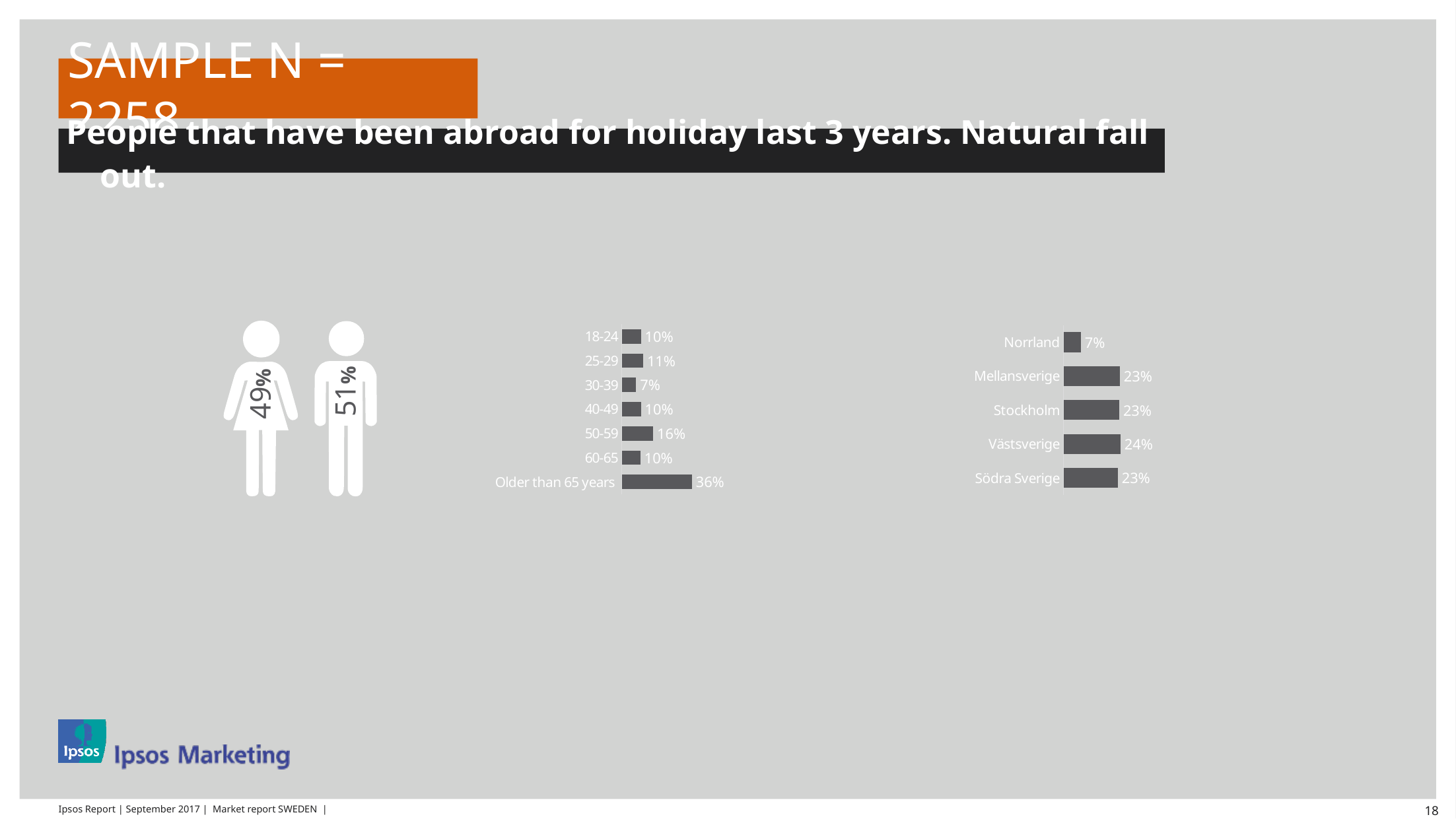
In the age-group bar chart in the middle of the slide, which age group has the lowest value? 30-39 In the region bar chart on the right of the slide, what is the difference between the values for Västsverige and Norrland? 17% In the age-group bar chart in the middle of the slide, how many age groups are shown? 7 In the region bar chart on the right of the slide, which region has the highest value? Västsverige In the region bar chart on the right of the slide, which region has the lowest value? Norrland In the age-group bar chart in the middle of the slide, what is the value for the 50-59 group? 16% In the region bar chart on the right of the slide, how many regions are shown? 5 In the age-group bar chart in the middle of the slide, what is the value for the 25-29 group? 11% What kind of chart is the region chart on the right of the slide? Bar chart In the age-group bar chart in the middle of the slide, what is the difference between the values for Older than 65 years and 50-59? 20% In the region bar chart on the right of the slide, what is the value for Norrland? 7% In the age-group bar chart in the middle of the slide, which age group has the highest value? Older than 65 years